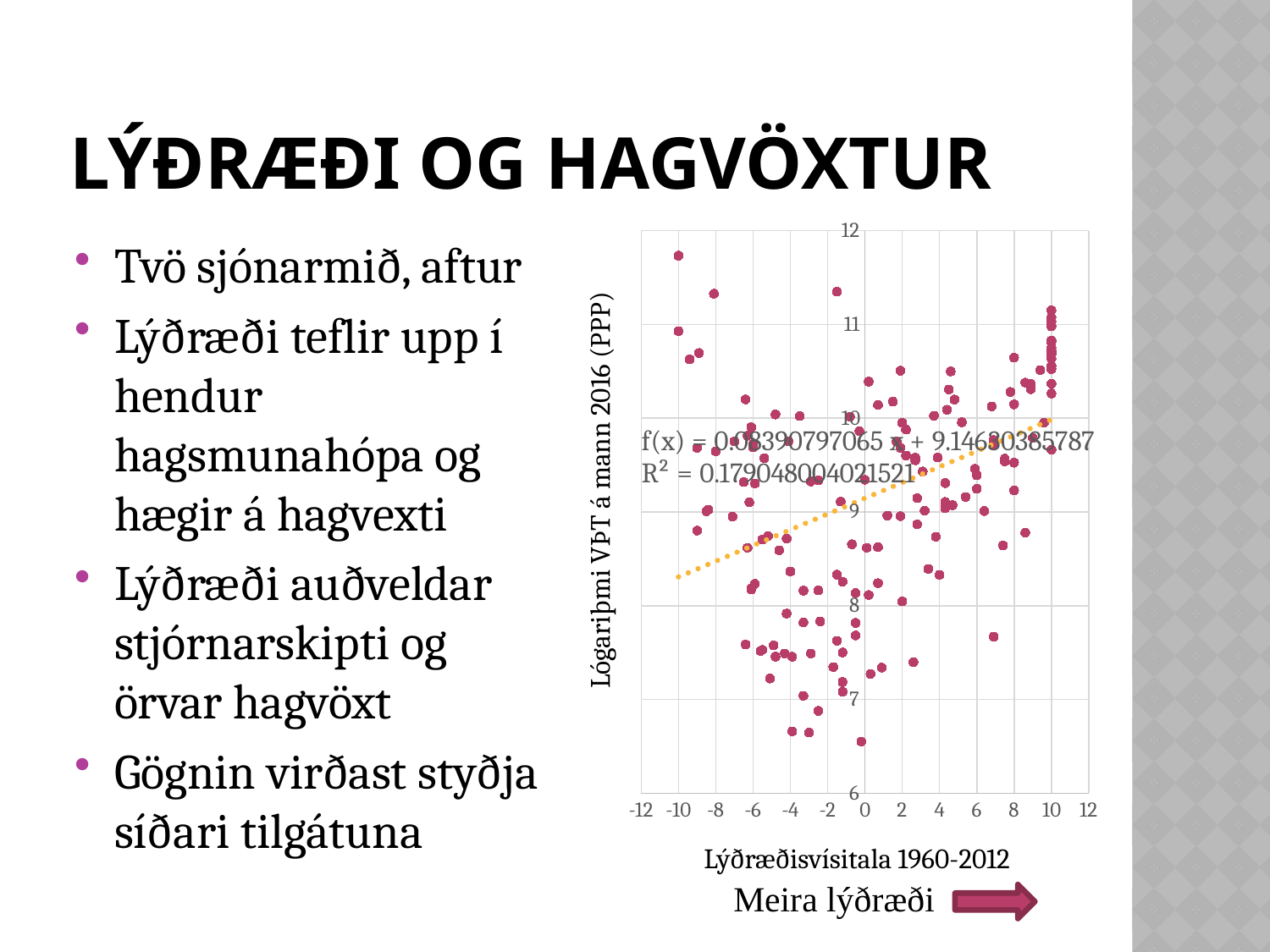
Is the y value of the lowest plotted point in the scatter chart greater or less than 7? less What is the label of the x axis of the scatter chart? Lýðræðisvísitala 1960-2012 Is the y value of the highest plotted point in the scatter chart greater or less than 11? greater What kind of chart is shown on the slide? Scatter chart What is the label of the y axis of the scatter chart? Lógariþmi VÞT á mann 2016 (PPP) Is the slope of the fitted trendline in the scatter chart positive or negative? Positive What is the lowest tick value shown on the y axis of the scatter chart? 6 What is the highest tick value shown on the y axis of the scatter chart? 12 What is the lowest tick value shown on the x axis of the scatter chart? -12 Does the dotted trendline in the scatter chart rise or fall as the democracy index (x axis) increases? Rise What is the highest tick value shown on the x axis of the scatter chart? 12